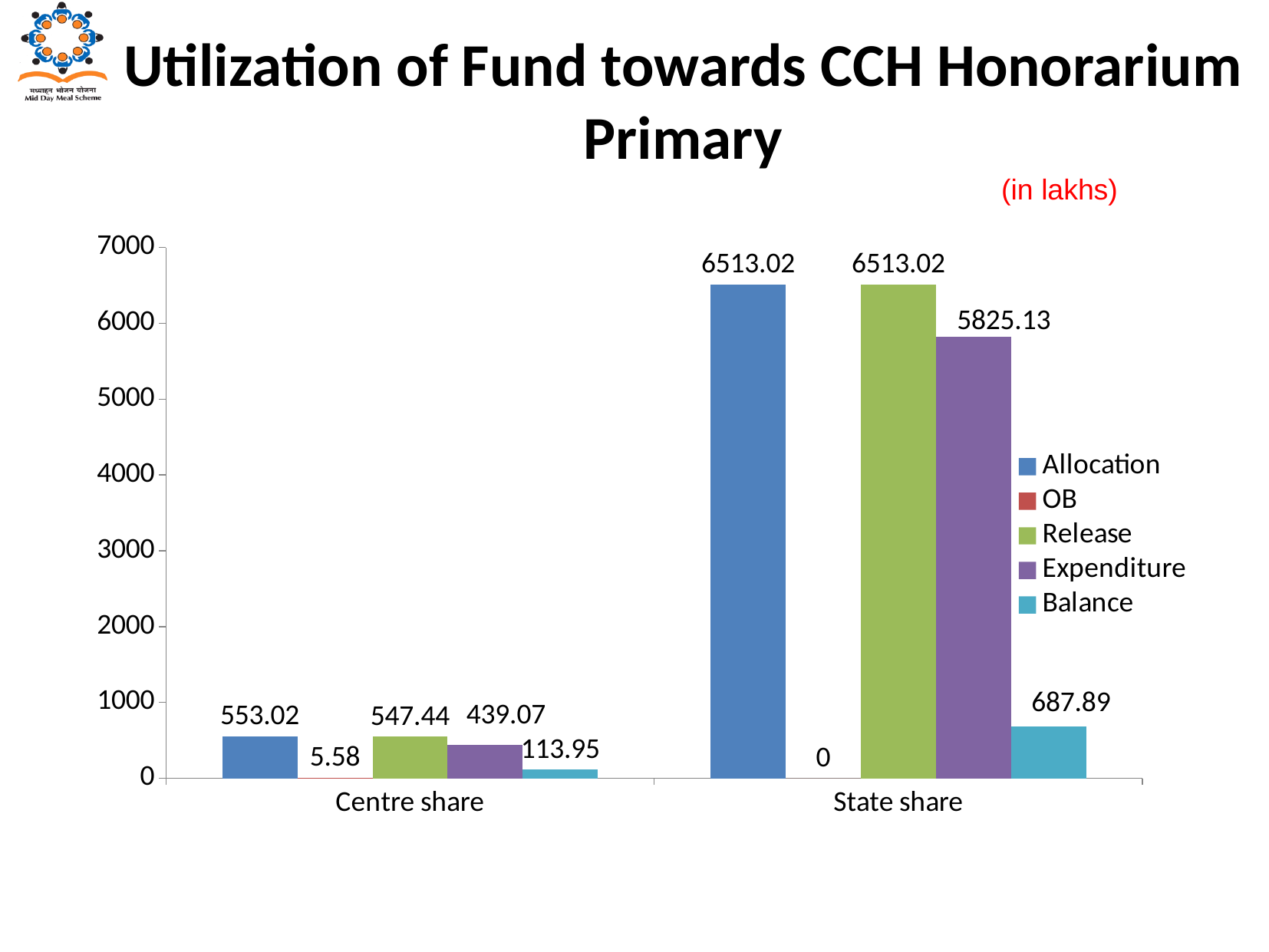
What is the difference between Release and Expenditure for State share? 687.89 Which series has the lowest value for State share? OB What is the Balance value for State share? 687.89 How many categories are shown on the x axis? 2 What is the Expenditure value for State share? 5825.13 How many series does the legend list? 5 Which series has the highest value for Centre share? Allocation What unit is stated for the values in the chart? in lakhs Which is larger: the Expenditure for Centre share or the Balance for Centre share? Expenditure for Centre share What is the Allocation value for Centre share? 553.02 What is the OB value for Centre share? 5.58 What kind of chart is shown on the slide? Bar chart